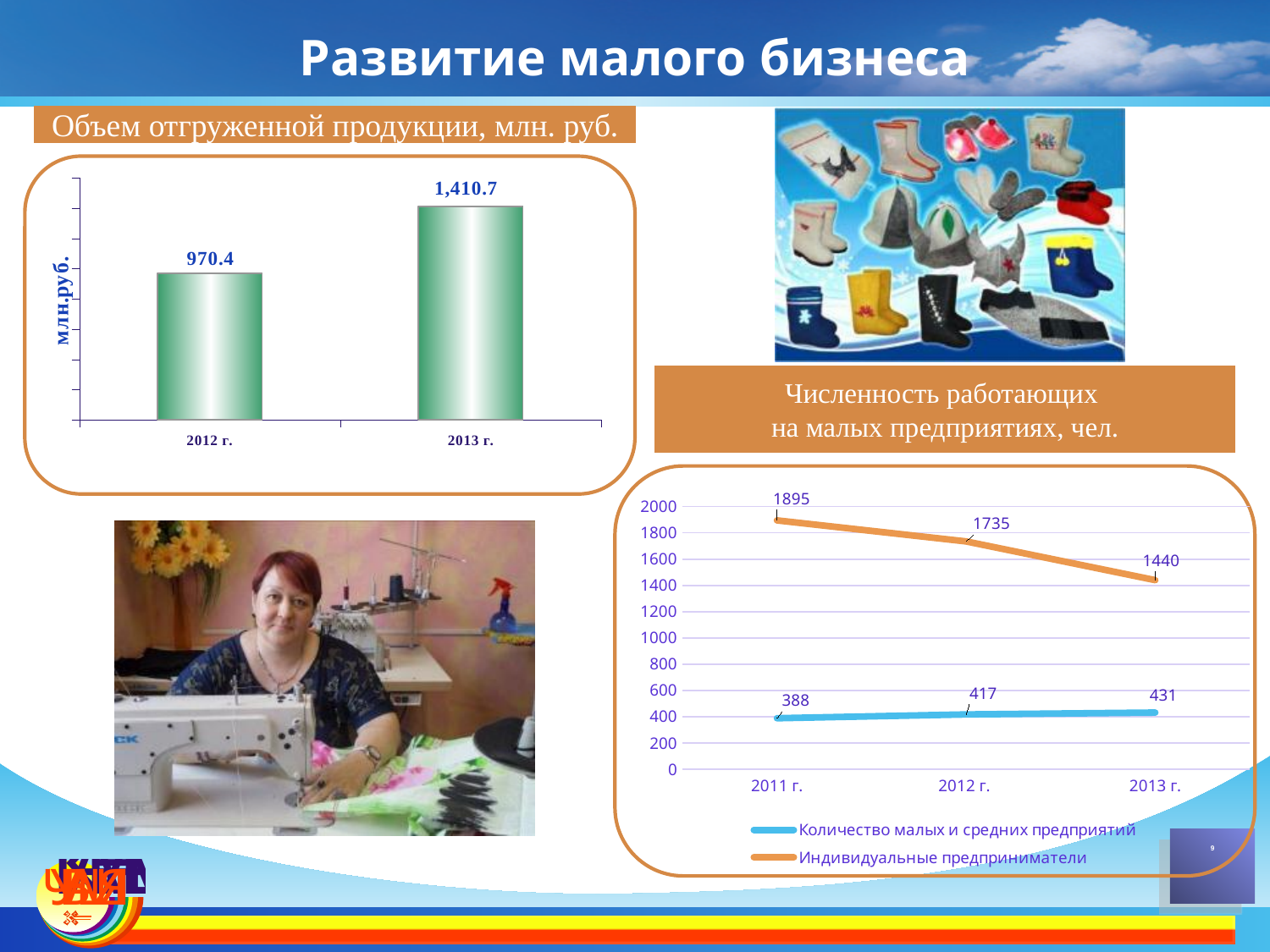
In the line chart 'Численность работающих на малых предприятиях, чел.', which series is shown in orange? Индивидуальные предприниматели In the bar chart 'Объем отгруженной продукции, млн. руб.', what is the value for 2013 г.? 1,410.7 In the line chart 'Численность работающих на малых предприятиях, чел.', what is the value for Количество малых и средних предприятий in 2013 г.? 431 How many series does the legend of the line chart 'Численность работающих на малых предприятиях, чел.' list? 2 How many categories are shown in the bar chart 'Объем отгруженной продукции, млн. руб.'? 2 What type of chart is 'Объем отгруженной продукции, млн. руб.'? bar chart In the line chart 'Численность работающих на малых предприятиях, чел.', in which year is the value for Индивидуальные предприниматели lowest? 2013 г. In the line chart 'Численность работающих на малых предприятиях, чел.', does the Индивидуальные предприниматели series rise or fall from 2011 г. to 2013 г.? fall In the bar chart 'Объем отгруженной продукции, млн. руб.', what is the value for 2012 г.? 970.4 In the line chart 'Численность работающих на малых предприятиях, чел.', what is the difference between Индивидуальные предприниматели in 2011 г. and 2013 г.? 455 In the line chart 'Численность работающих на малых предприятиях, чел.', what is the value for Индивидуальные предприниматели in 2011 г.? 1895 In the bar chart 'Объем отгруженной продукции, млн. руб.', by how much did the value increase from 2012 г. to 2013 г.? 440.3